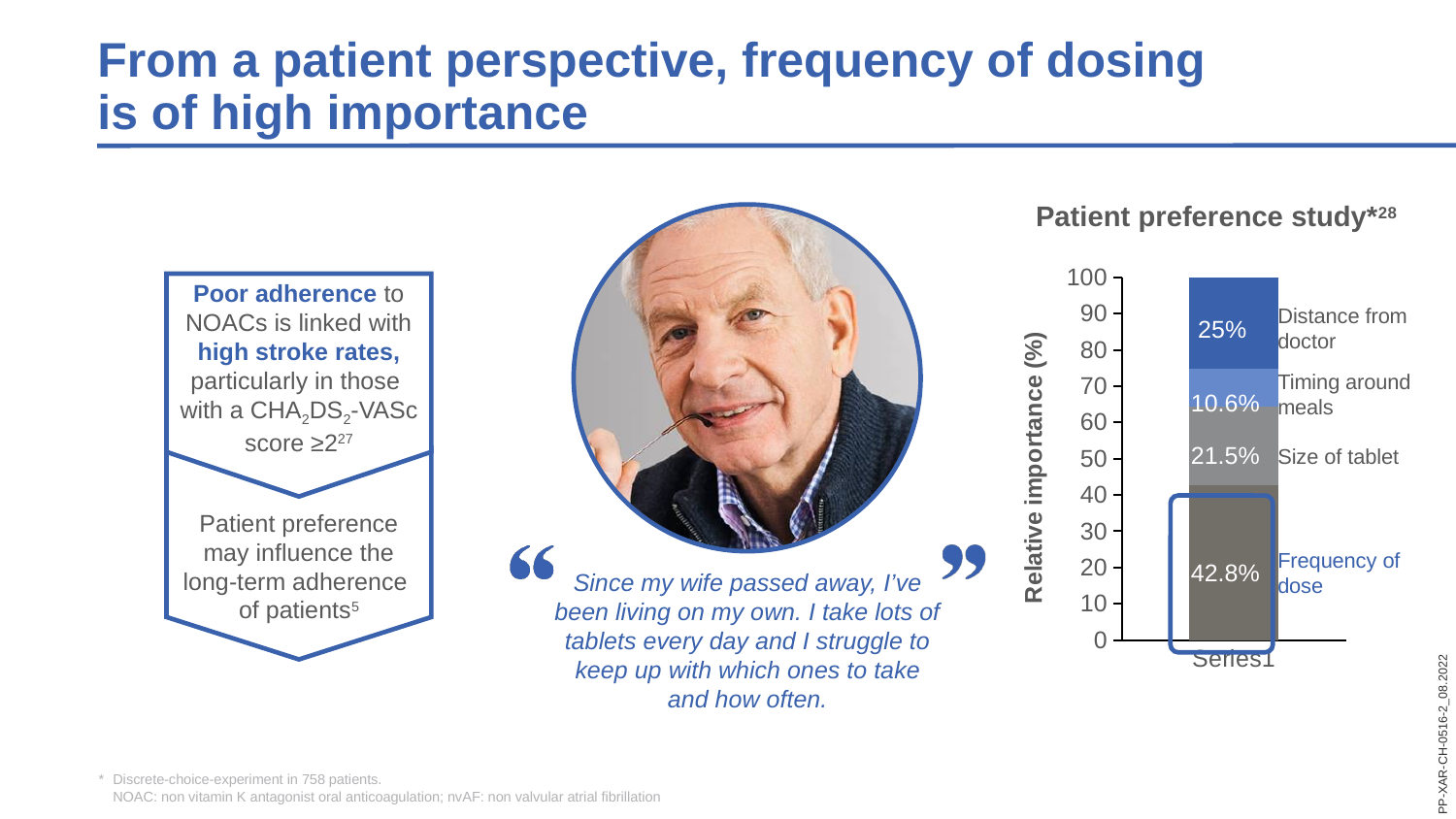
What is the relative importance value for Distance from doctor in the Patient preference study chart? 25% In the Patient preference study chart, which is larger: the value for Size of tablet or for Distance from doctor? Distance from doctor In the Patient preference study chart, how much higher is the value for Size of tablet than for Timing around meals? 10.9 percentage points What is the relative importance value for Size of tablet in the Patient preference study chart? 21.5% What is the label of the vertical axis in the Patient preference study chart? Relative importance (%) What is the relative importance value for Frequency of dose in the Patient preference study chart? 42.8% What kind of chart is the Patient preference study chart? Stacked bar chart Which attribute has the lowest relative importance in the Patient preference study chart? Timing around meals In the Patient preference study chart, how much higher is the value for Frequency of dose than for Distance from doctor? 17.8 percentage points How many segments make up the stacked bar in the Patient preference study chart? 4 Which attribute has the highest relative importance in the Patient preference study chart? Frequency of dose What is the relative importance value for Timing around meals in the Patient preference study chart? 10.6%